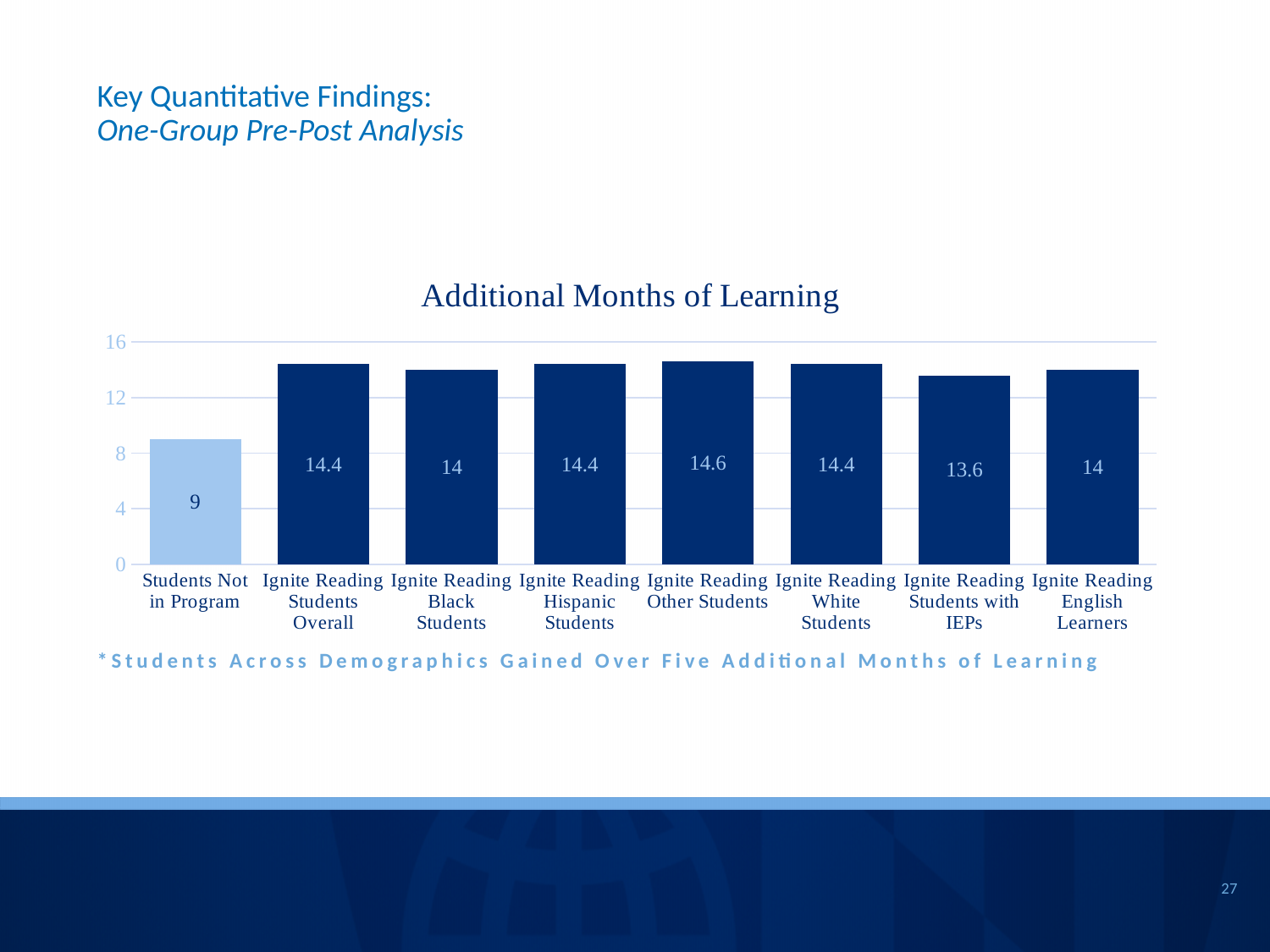
Which category has the highest value? Ignite Reading Other Students What is the title of the chart? Additional Months of Learning How many categories are shown on the x axis? 8 Is the value for Ignite Reading White Students greater or less than 12? greater What is the value for Ignite Reading Students with IEPs? 13.6 What is the difference between Ignite Reading Students Overall and Students Not in Program? 5.4 What is the value for Ignite Reading English Learners? 14 What kind of chart is this? Bar chart Which is larger, the value for Ignite Reading Black Students or Ignite Reading Students with IEPs? Ignite Reading Black Students What is the value for Ignite Reading Other Students? 14.6 Which category has the lowest value? Students Not in Program What is the value for Students Not in Program? 9